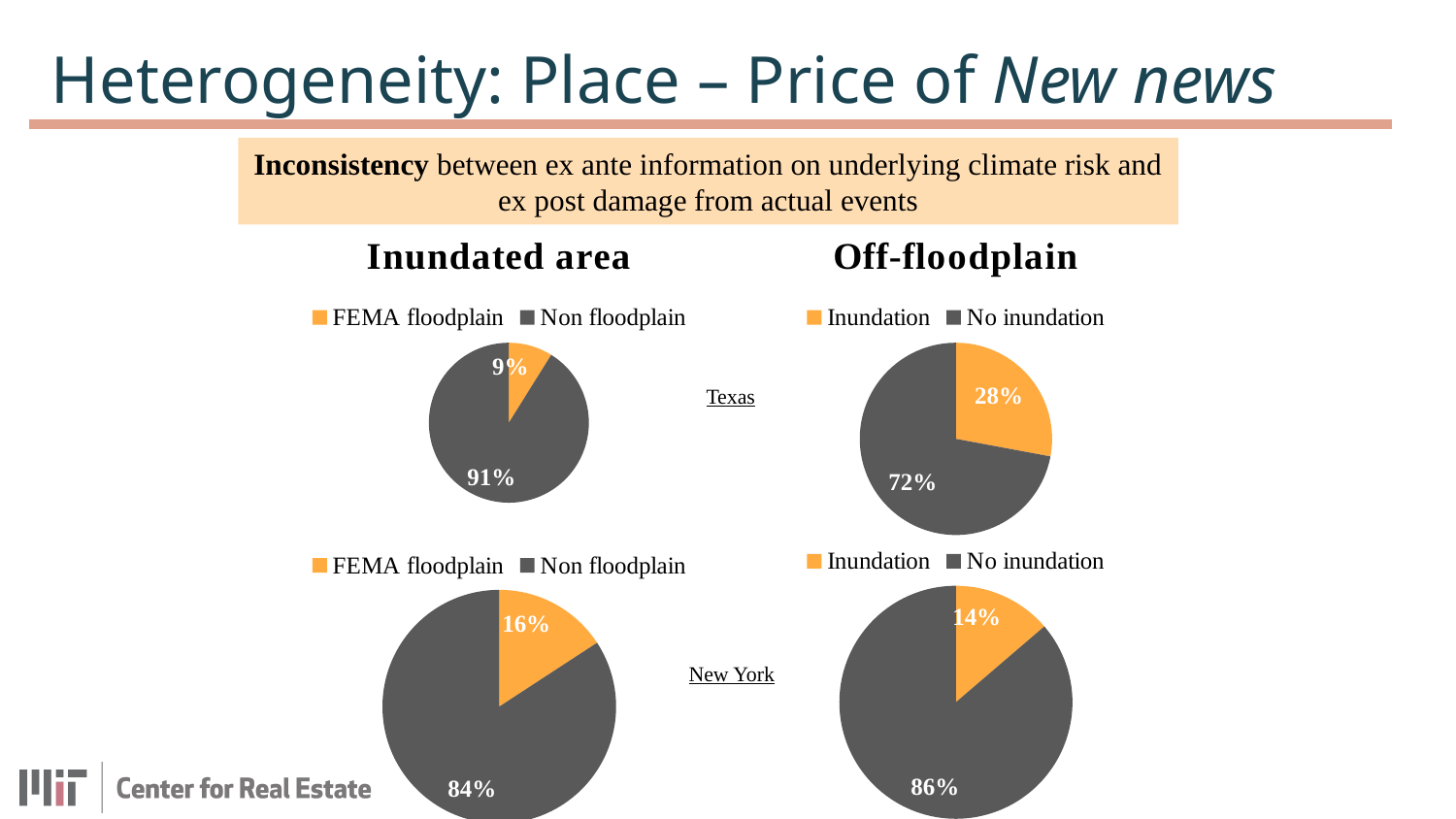
In the Texas Off-floodplain pie chart, what share is Inundation? 28% How many slices does the New York Inundated area pie chart have? 2 What type of chart is used for the Texas Off-floodplain data? Pie chart In the Texas Inundated area pie chart, what share is FEMA floodplain? 9% In the New York Inundated area pie chart, which slice is larger, FEMA floodplain or Non floodplain? Non floodplain How many entries does the legend of the Texas Off-floodplain pie chart list? 2 In the New York Off-floodplain pie chart, what share is No inundation? 86% In the Texas Off-floodplain pie chart, what share is No inundation? 72% What is the difference between the No inundation and Inundation shares in the New York Off-floodplain pie chart? 72% In the New York Inundated area pie chart, what share is FEMA floodplain? 16% In the Texas Inundated area pie chart, what share is Non floodplain? 91% What is the difference between the Non floodplain and FEMA floodplain shares in the Texas Inundated area pie chart? 82%